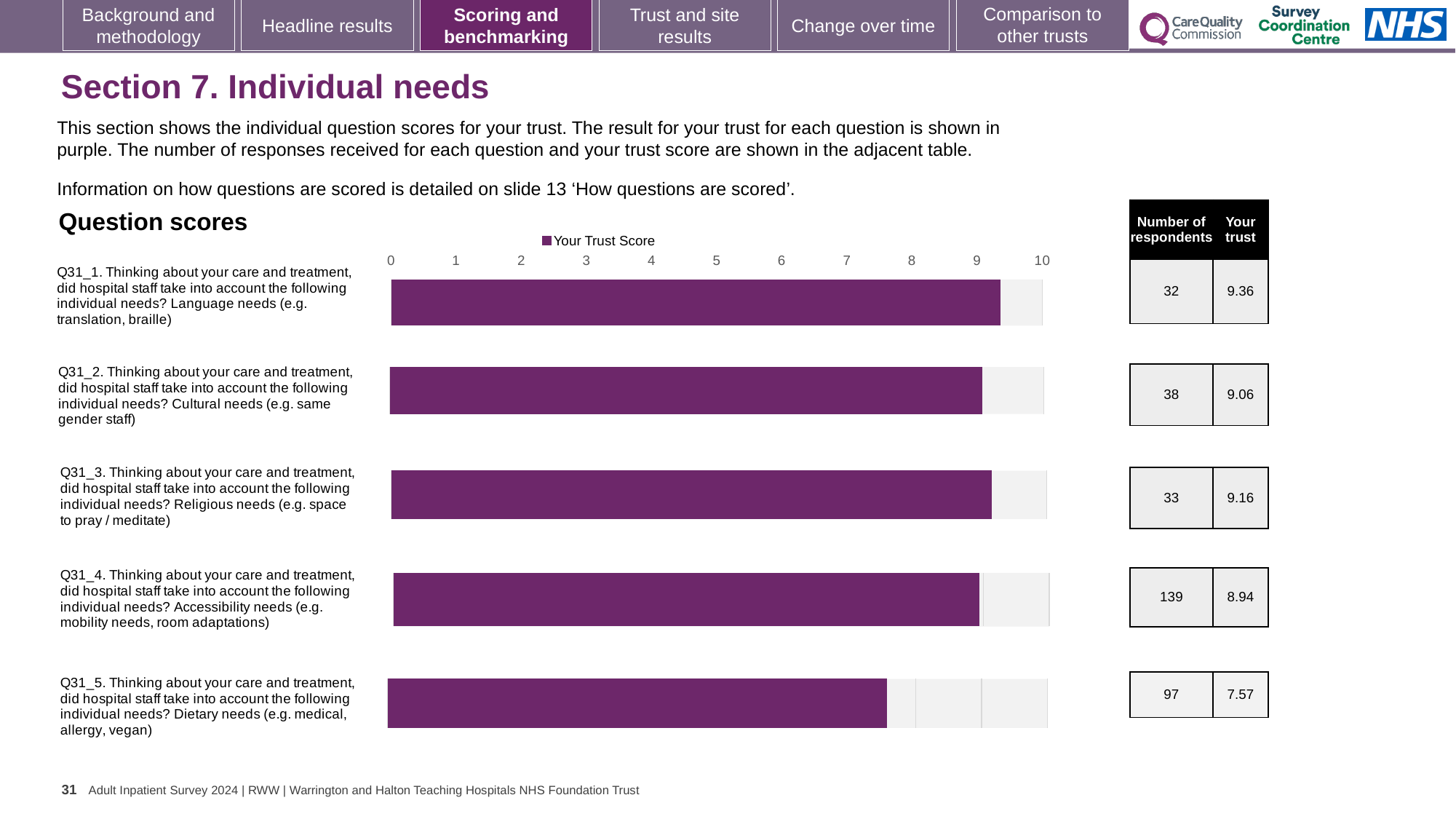
What is the name of the series shown in the chart legend? Your Trust Score What is the difference between the trust scores for Q31_1 and Q31_5? 1.79 Which question has the highest trust score? Q31_1 (Language needs) What type of chart is shown on the slide? Bar chart Which has a higher trust score, Q31_2 (Cultural needs) or Q31_3 (Religious needs)? Q31_3 (Religious needs) What is the trust score for Q31_4 (Accessibility needs)? 8.94 What is the trust score for Q31_1 (Language needs)? 9.36 What is the trust score for Q31_5 (Dietary needs)? 7.57 Which question has the lowest trust score? Q31_5 (Dietary needs) How many series does the chart legend list? 1 Is the trust score for Q31_5 (Dietary needs) greater or less than 8? less How many questions are plotted in the chart? 5